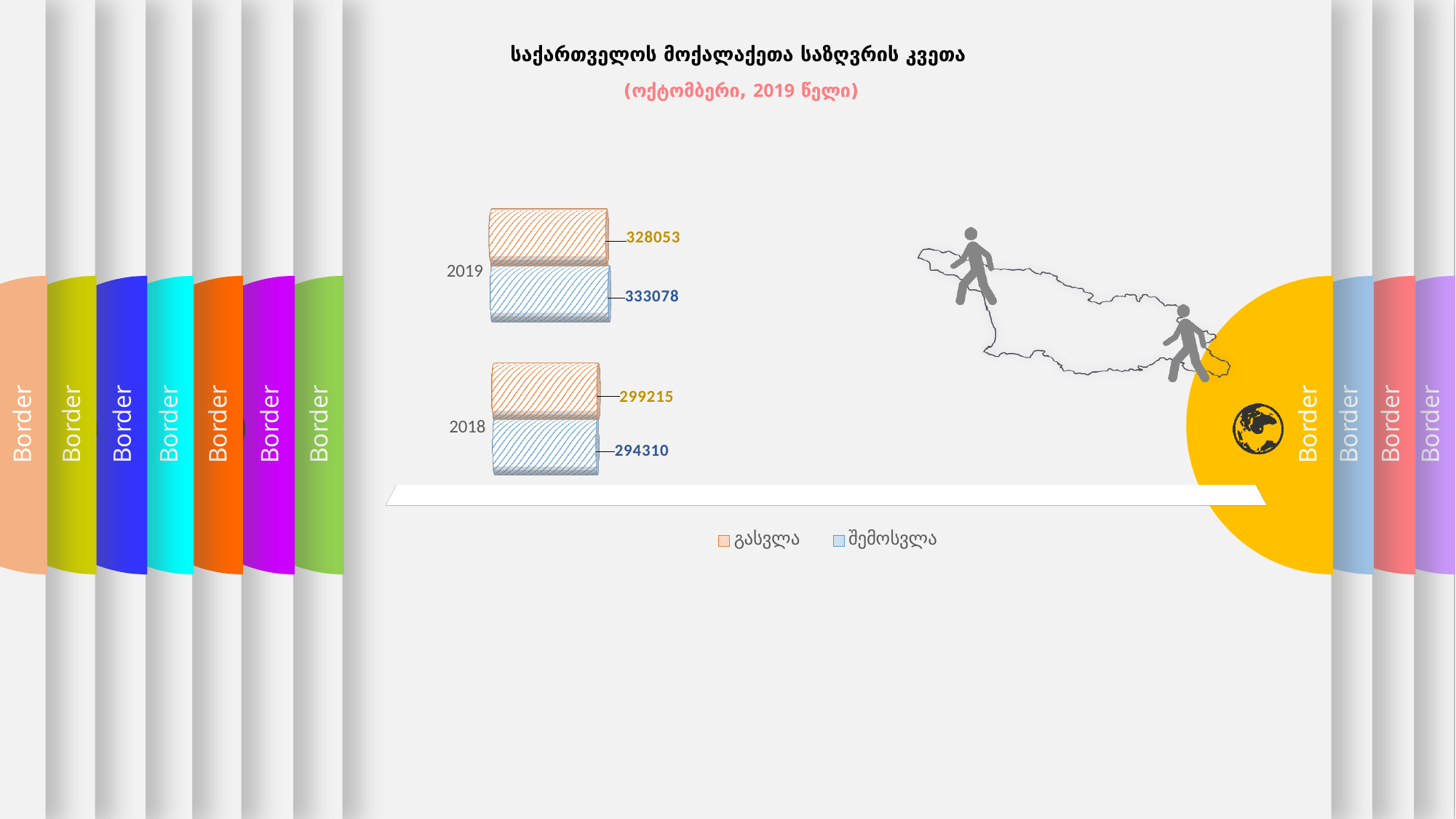
What is the value for გასვლა in 2018? 299215 How many series does the legend list? 2 How many years are shown on the chart? 2 What is the value for გასვლა in 2019? 328053 Which year has the lower value for გასვლა? 2018 What kind of chart is shown on the slide? Bar chart What is the value for შემოსვლა in 2018? 294310 In 2018, which is larger: გასვლა or შემოსვლა? გასვლა What is the difference between შემოსვლა and გასვლა in 2019? 5025 What is the value for შემოსვლა in 2019? 333078 Which year has the higher value for შემოსვლა? 2019 What is the difference between გასვლა in 2019 and გასვლა in 2018? 28838